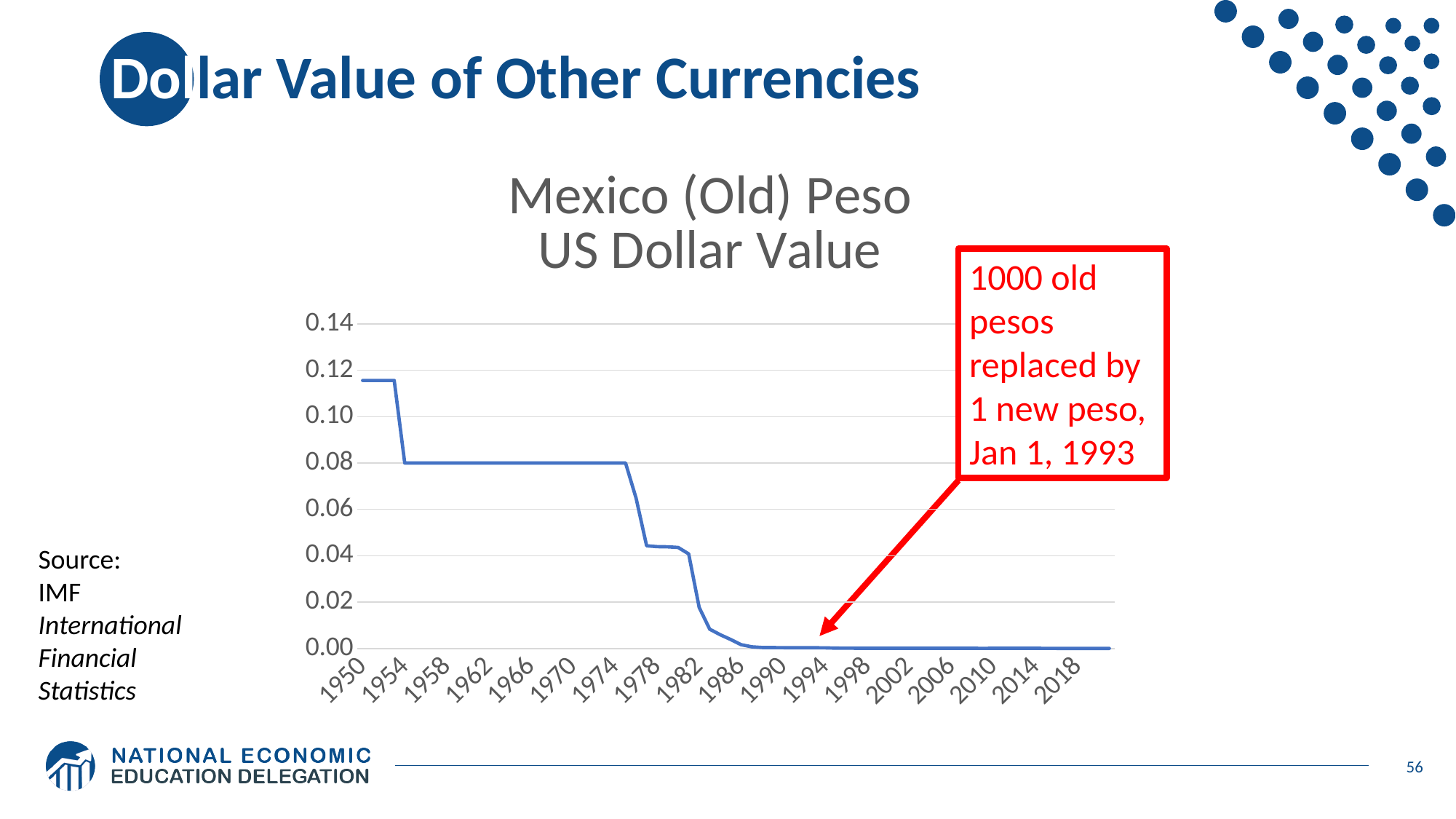
Which year on the x axis has the highest value? 1950 Do the values rise or fall along the x axis from 1950 to 2018? fall How many year labels are shown on the x axis? 18 What kind of chart is shown on the slide? line chart Is the value for 1950 greater or less than 0.10? greater Is the value for 1966 greater or less than 0.10? less Is the value for 1990 greater or less than 0.02? less Which is larger, the value for 1954 or the value for 1986? 1954 What is the title of the chart? Mexico (Old) Peso US Dollar Value What does the red annotation box on the chart say? 1000 old pesos replaced by 1 new peso, Jan 1, 1993